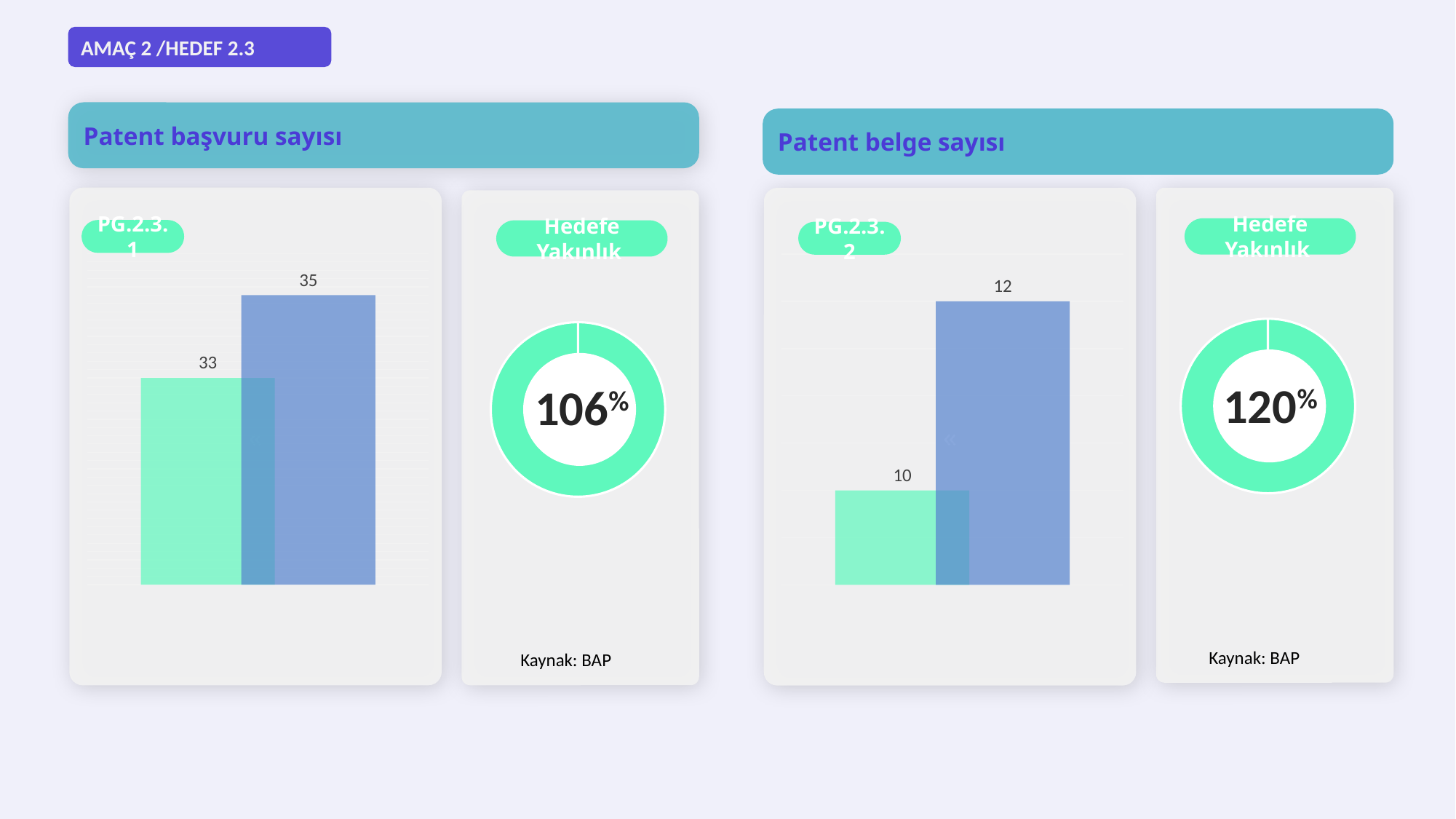
What percentage is shown in the 'Hedefe Yakınlık' donut chart under 'Patent belge sayısı'? 120% In the 'Patent belge sayısı' bar chart, what is the value of the blue bar? 12 In the 'Patent belge sayısı' bar chart, what is the value of the green bar? 10 In the 'Patent belge sayısı' bar chart, what is the difference between the blue bar and the green bar? 2 In the 'Patent başvuru sayısı' bar chart, what is the value of the blue bar? 35 In the 'Patent belge sayısı' bar chart, which bar is taller, the green one or the blue one? the blue one In the 'Patent başvuru sayısı' bar chart, what is the value of the green bar? 33 In the 'Patent başvuru sayısı' bar chart, what is the difference between the blue bar and the green bar? 2 What percentage is shown in the 'Hedefe Yakınlık' donut chart under 'Patent başvuru sayısı'? 106% What source is cited below the 'Hedefe Yakınlık' donut charts? Kaynak: BAP How many bars are plotted in the 'Patent başvuru sayısı' chart? 2 What kind of chart is shown under the 'PG.2.3.1' label? bar chart